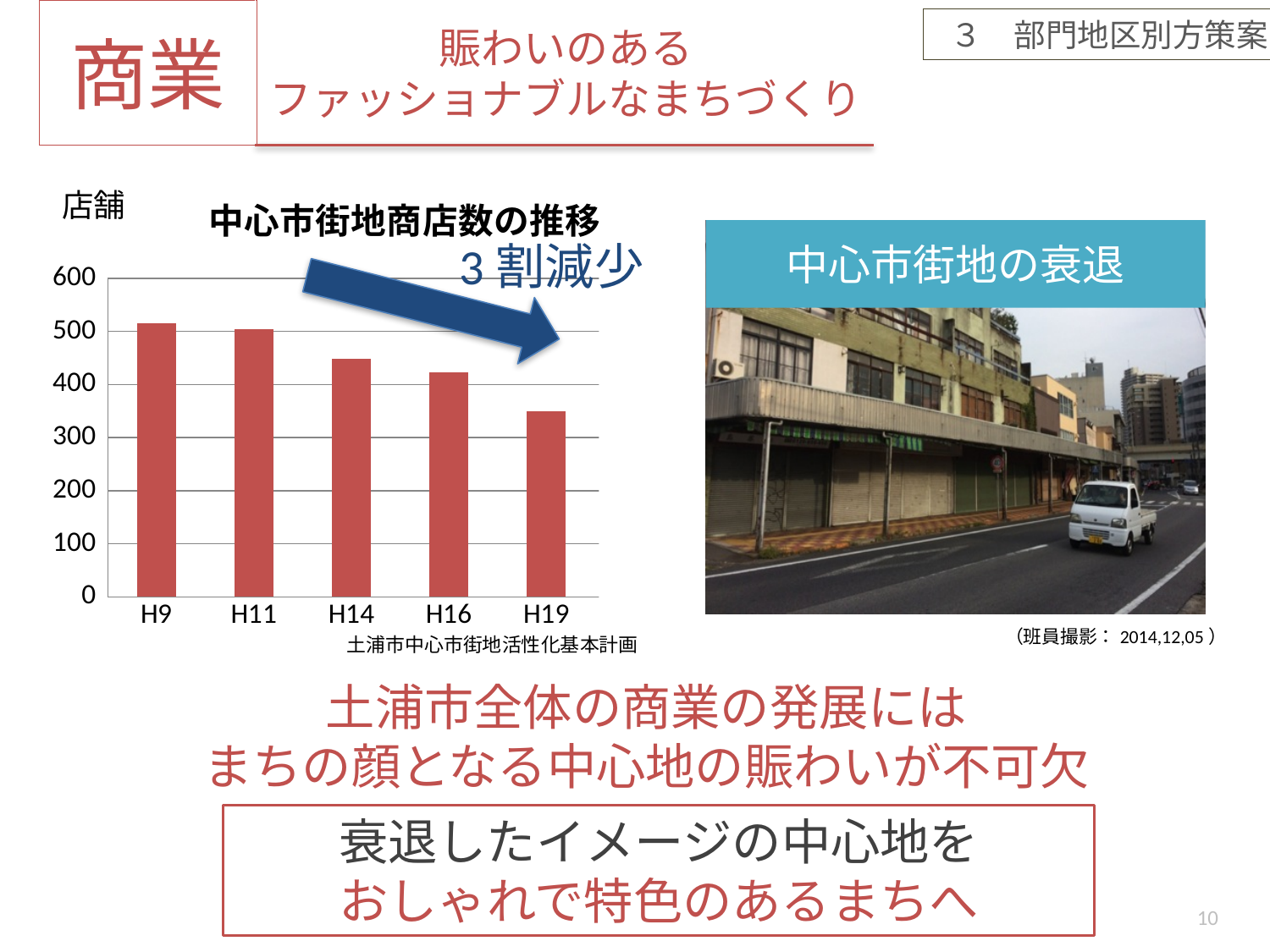
Is the value for H14 greater or less than 400? greater Which is larger, the value for H9 or the value for H16? H9 Is the value for H9 greater or less than 500? greater What kind of chart is shown on the slide? bar chart How many categories (years) are shown on the x axis of the chart? 5 Do the values in the chart rise or fall from H9 to H19? fall Which is larger, the value for H14 or the value for H19? H14 Is the value for H19 greater or less than 400? less What is the title of the chart? 中心市街地商店数の推移 What unit label is shown above the y axis of the chart? 店舗 Which year has the lowest number of shops in the chart? H19